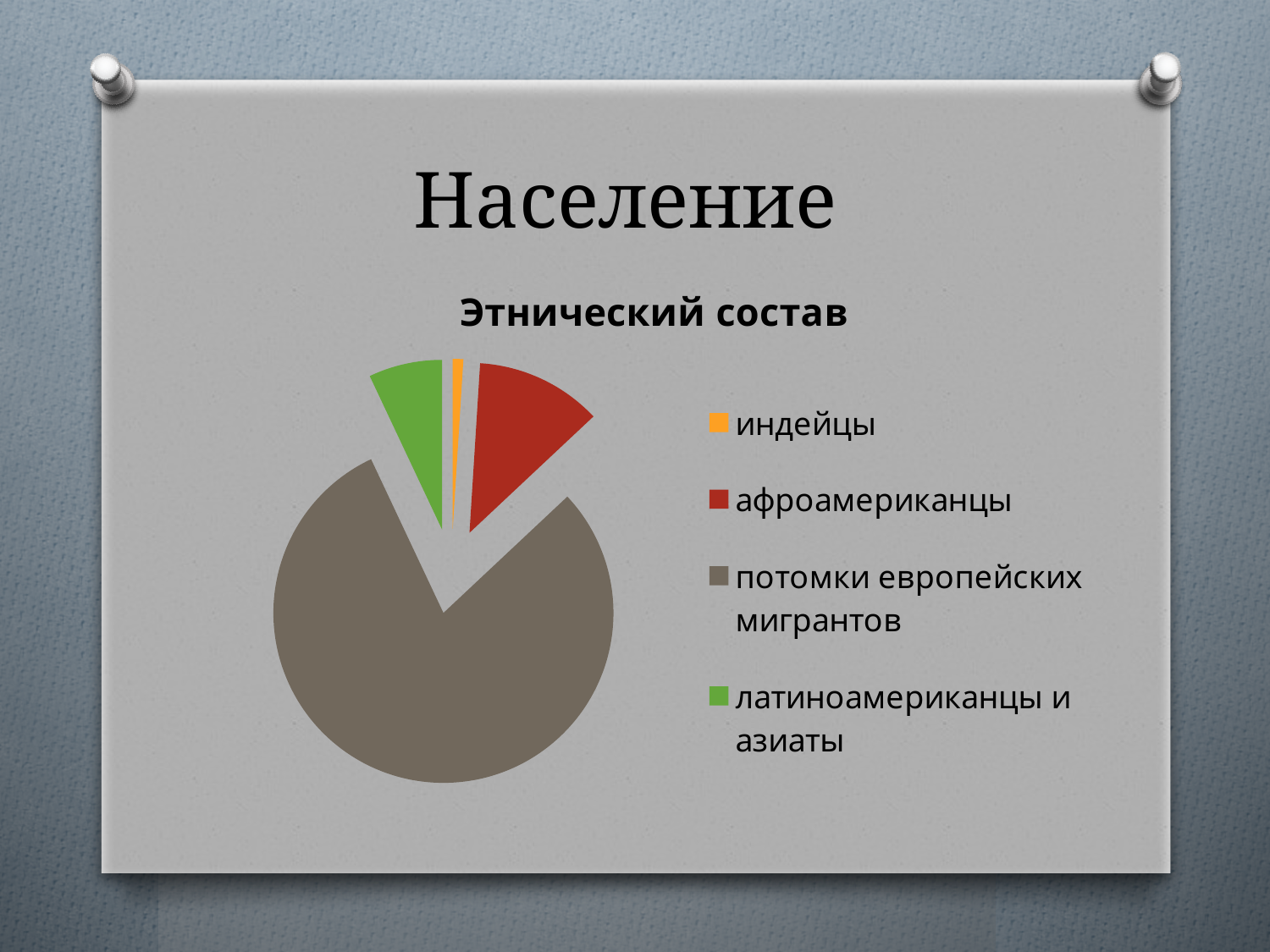
Which category has the smallest share of the pie? индейцы Which slice is larger: индейцы or латиноамериканцы и азиаты? латиноамериканцы и азиаты Which category has the largest share of the pie? потомки европейских мигрантов How many categories does the pie chart show? 4 Which slice is larger: афроамериканцы or латиноамериканцы и азиаты? афроамериканцы Which category is shown in green? латиноамериканцы и азиаты What kind of chart is shown on the slide? pie chart What is the title of the chart? Этнический состав Which slice is larger: потомки европейских мигрантов or афроамериканцы? потомки европейских мигрантов What colour is the slice for индейцы? orange